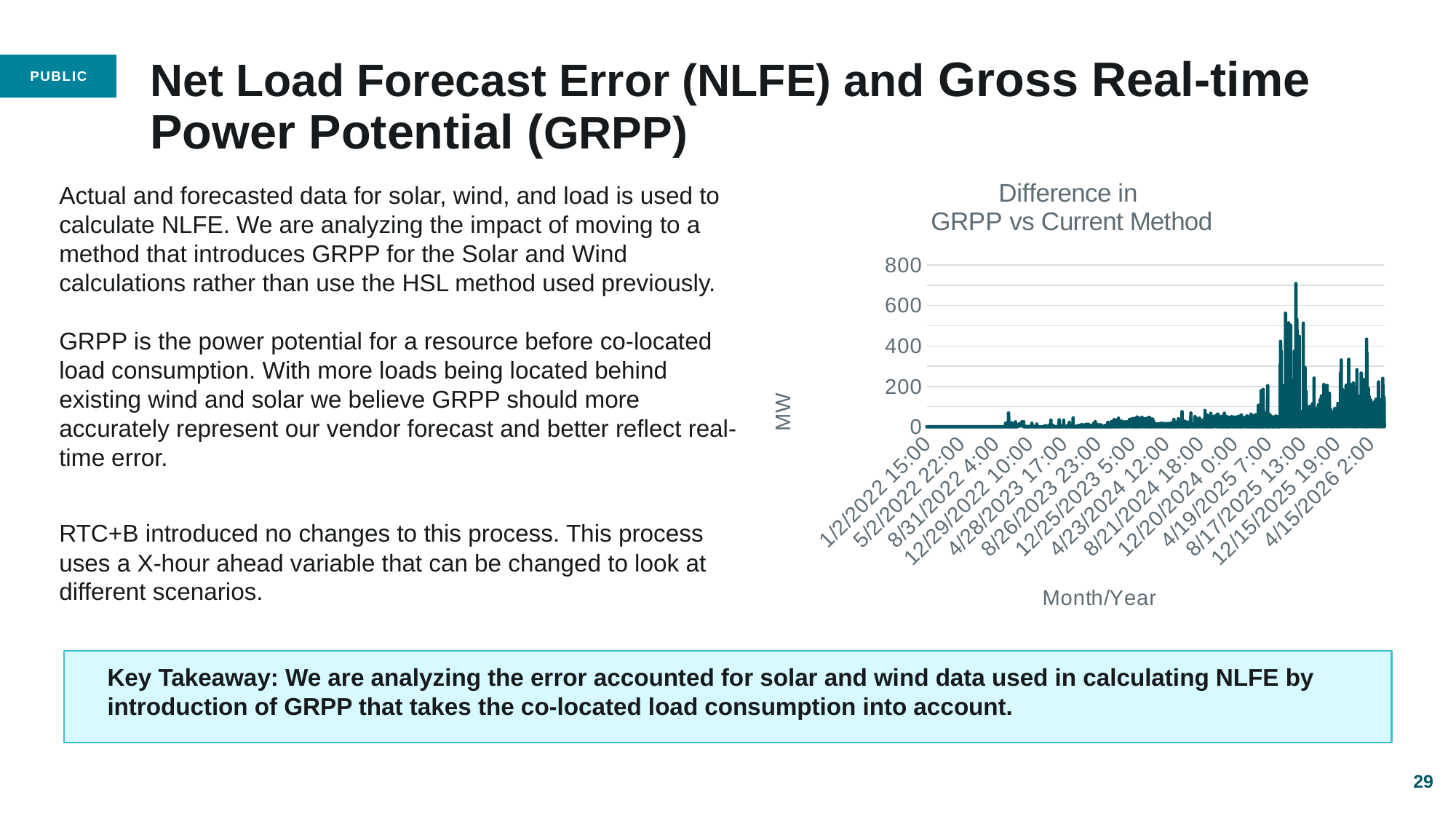
Are the values around 1/2/2022 15:00 greater or less than 200? less In which part of the time range do the largest differences occur, the beginning or the end? the end Is the highest peak in the chart greater or less than 600? greater How many date labels are printed along the horizontal axis of the chart? 14 What is the first date label on the horizontal axis of the chart? 1/2/2022 15:00 Do the values in the chart generally rise or fall from left to right along the horizontal axis? rise What is the title of the chart? Difference in GRPP vs Current Method What is the highest value shown on the vertical axis of the chart? 800 What is the last date label on the horizontal axis of the chart? 4/15/2026 2:00 Is the highest peak in the chart greater or less than 800? less What label is shown on the vertical axis of the chart? MW